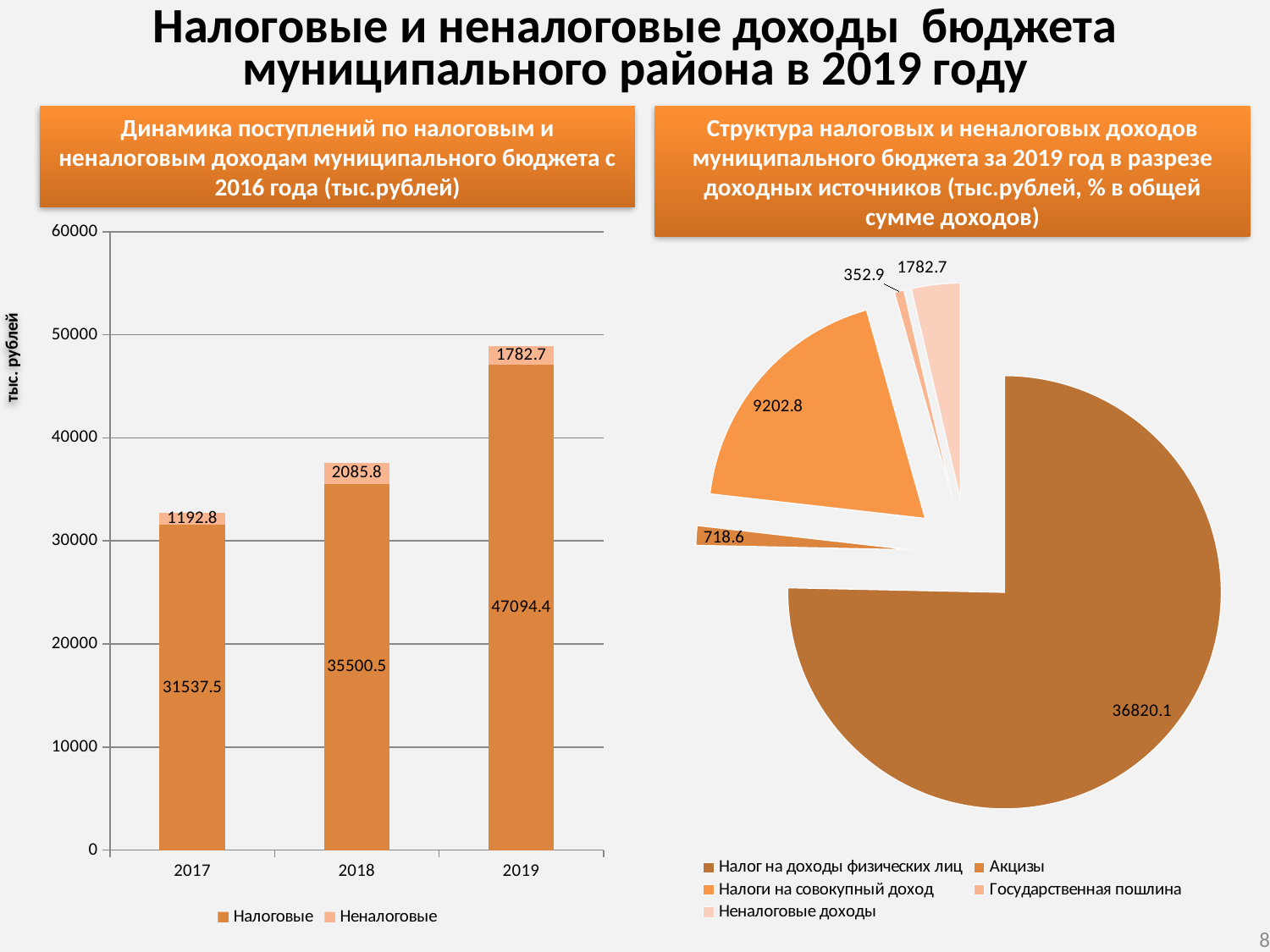
In the left chart (Динамика поступлений), which year has the lowest Налоговые value? 2017 In the left chart (Динамика поступлений), do the Налоговые values rise or fall from 2017 to 2019? rise In the left chart (Динамика поступлений), what is the value of Налоговые for 2019? 47094.4 In the right pie chart, which is larger: Акцизы or Неналоговые доходы? Неналоговые доходы In the right pie chart, which category has the smallest value? Государственная пошлина In the left chart (Динамика поступлений), what is the total of the stacked bar for 2019? 48877.1 What kind of chart is the right chart (Структура налоговых и неналоговых доходов)? pie chart In the left chart (Динамика поступлений), how many series does the legend list? 2 In the left chart (Динамика поступлений), which year has the highest Неналоговые value? 2018 In the left chart (Динамика поступлений), what is the difference between the Налоговые values for 2019 and 2018? 11593.9 In the left chart (Динамика поступлений), what is the value of Неналоговые for 2017? 1192.8 In the right pie chart, what is the value for Налоги на совокупный доход? 9202.8